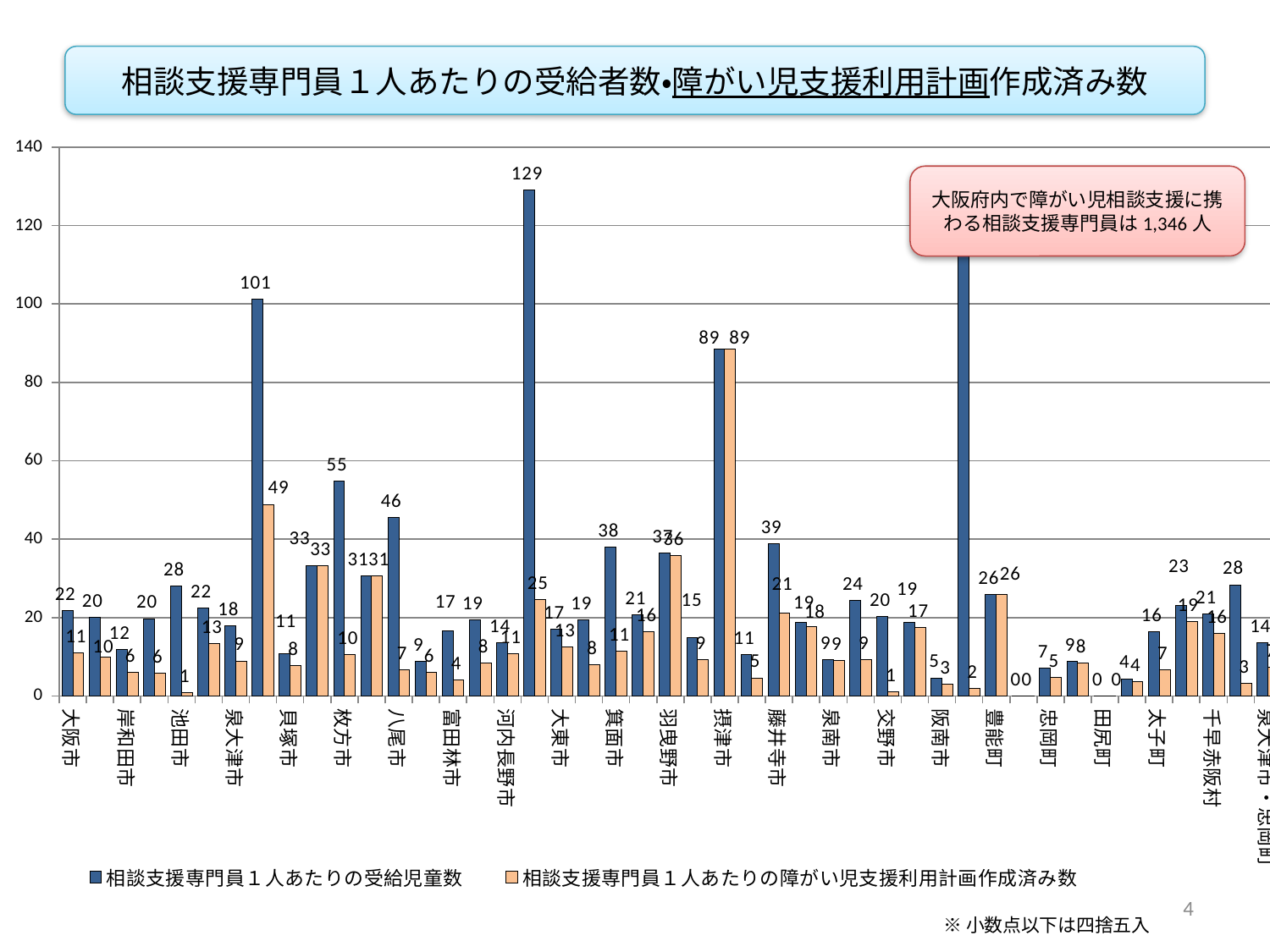
What is the value of 相談支援専門員１人あたりの受給児童数 for 摂津市? 89 Which is larger: the 相談支援専門員１人あたりの受給児童数 value for 枚方市 or for 八尾市? 枚方市 What kind of chart is shown on the slide? bar chart What is the value of 相談支援専門員１人あたりの障がい児支援利用計画作成済み数 for 摂津市? 89 How many series does the legend list? 2 Which labelled category has the highest value for 相談支援専門員１人あたりの障がい児支援利用計画作成済み数? 摂津市 What is the difference between the two series for 枚方市? 45 What is the value of 相談支援専門員１人あたりの受給児童数 for 枚方市? 55 According to the callout on the chart, how many 相談支援専門員 in 大阪府 are involved in 障がい児相談支援? 1,346 人 What is the value of 相談支援専門員１人あたりの障がい児支援利用計画作成済み数 for 八尾市? 7 What is the value of 相談支援専門員１人あたりの受給児童数 for 豊能町? 26 Is the value of 相談支援専門員１人あたりの受給児童数 for 摂津市 greater or less than 80? greater